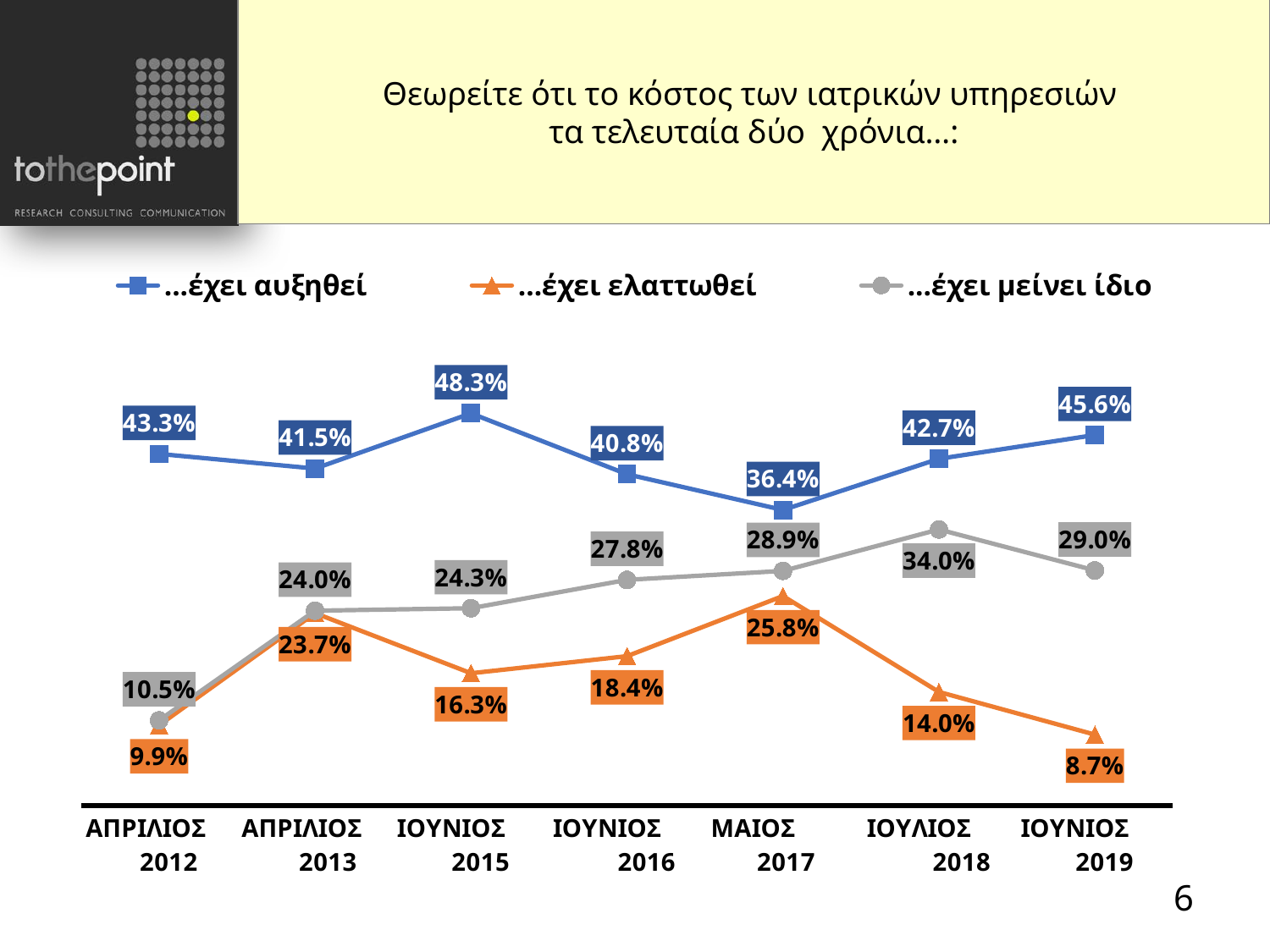
Which colour is used for the "...έχει ελαττωθεί" series? orange Does the value for "...έχει ελαττωθεί" rise or fall from ΜΑΙΟΣ 2017 to ΙΟΥΝΙΟΣ 2019? fall How many series does the legend list? 3 What is the value for "...έχει μείνει ίδιο" in ΙΟΥΛΙΟΣ 2018? 34.0% What type of chart is shown on the slide? line chart How many time points are plotted along the x axis? 7 What is the difference between the "...έχει αυξηθεί" values in ΙΟΥΝΙΟΣ 2019 and ΜΑΙΟΣ 2017? 9.2% In which period is the value for "...έχει αυξηθεί" lowest? ΜΑΙΟΣ 2017 Which is larger in ΑΠΡΙΛΙΟΣ 2013: "...έχει ελαττωθεί" or "...έχει μείνει ίδιο"? ...έχει μείνει ίδιο In which period is the value for "...έχει μείνει ίδιο" highest? ΙΟΥΛΙΟΣ 2018 What is the value for "...έχει ελαττωθεί" in ΜΑΙΟΣ 2017? 25.8% What is the value for "...έχει αυξηθεί" in ΙΟΥΝΙΟΣ 2015? 48.3%